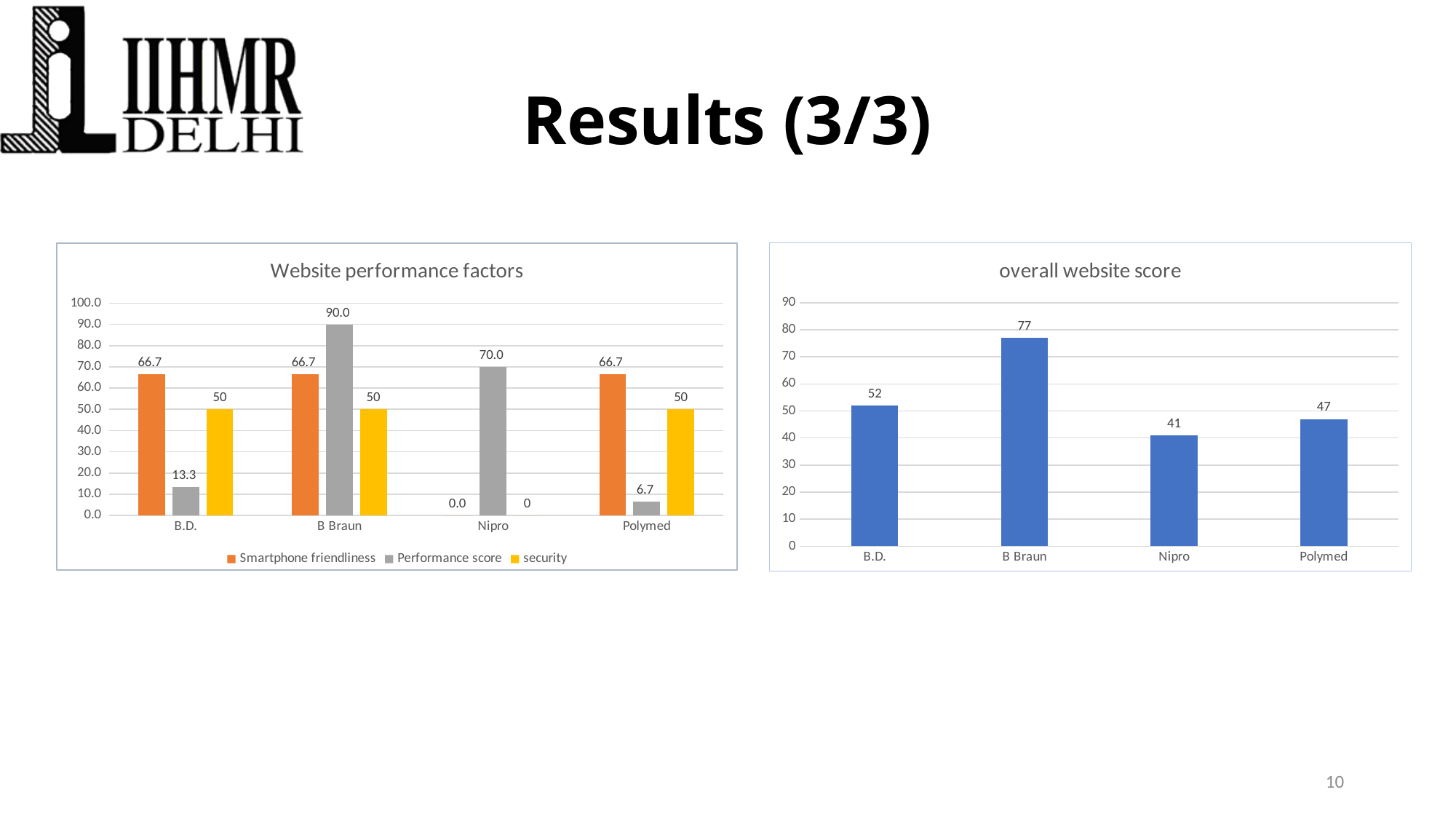
What type of chart is the 'overall website score' chart? Bar chart In the 'overall website score' chart, what is the score for Polymed? 47 In the 'Website performance factors' chart, which company has the highest Performance score? B Braun In the 'Website performance factors' chart, what is the Smartphone friendliness value for Nipro? 0.0 In the 'overall website score' chart, what is the difference between the scores of B Braun and Nipro? 36 In the 'Website performance factors' chart, what is the difference between the Performance score of B Braun and that of B.D.? 76.7 In the 'Website performance factors' chart, what is the Performance score for B Braun? 90.0 In the 'overall website score' chart, which company has the lowest score? Nipro In the 'Website performance factors' chart, what is the Performance score for Polymed? 6.7 In the 'Website performance factors' chart, which colour represents the security series? Yellow In the 'overall website score' chart, which is larger, the score for B.D. or the score for Polymed? B.D. In the 'Website performance factors' chart, how many series does the legend list? 3